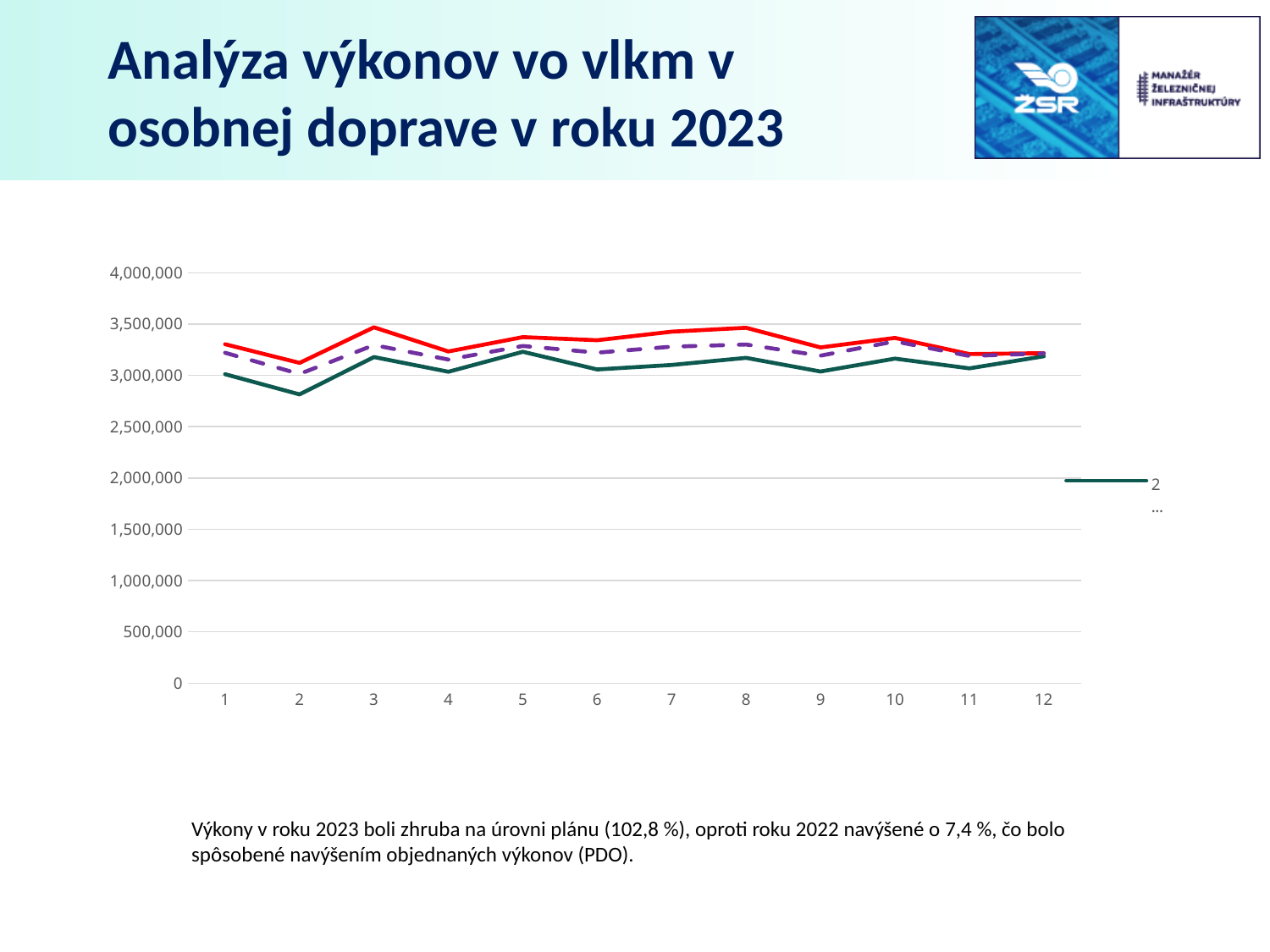
Is the value of the green line at x = 3 greater or less than 3,000,000? greater Does the green line rise or fall from x = 1 to x = 2? fall What kind of chart is shown on the slide? line chart How many lines are plotted in the chart? 3 At which x value does the green line reach its lowest point? 2 Does the red line rise or fall from x = 2 to x = 3? rise Is the value of the green line at x = 2 greater or less than 3,000,000? less What is the highest value shown on the y axis of the chart? 4,000,000 Is the value of the red line at x = 8 greater or less than 4,000,000? less At x = 2, which line has the higher value, the red line or the green line? the red line How many points are plotted along the x axis of the chart? 12